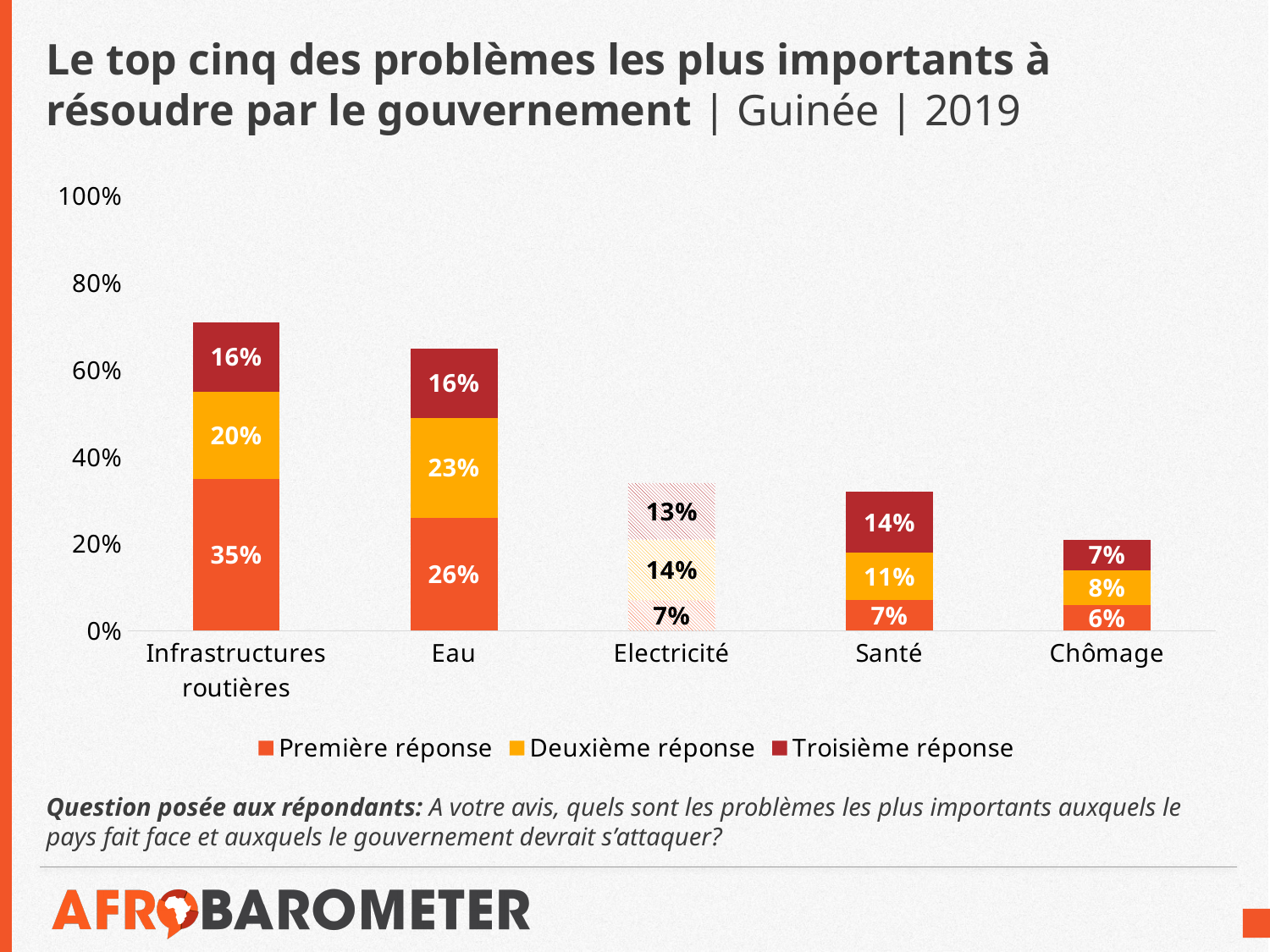
What is the total of the stacked bar for Eau? 65% What is the value of "Première réponse" for Infrastructures routières? 35% What is the value of "Première réponse" for Chômage? 6% Which category has the lowest "Deuxième réponse" value? Chômage How many series does the legend list? 3 What is the difference between the "Première réponse" values for Infrastructures routières and Eau? 9% What kind of chart is shown on the slide? Stacked bar chart What is the value of "Troisième réponse" for Santé? 14% How many categories are shown on the x axis? 5 Which category has the highest "Première réponse" value? Infrastructures routières What is the value of "Deuxième réponse" for Eau? 23% Which is larger: the "Deuxième réponse" value for Electricité or for Santé? Electricité